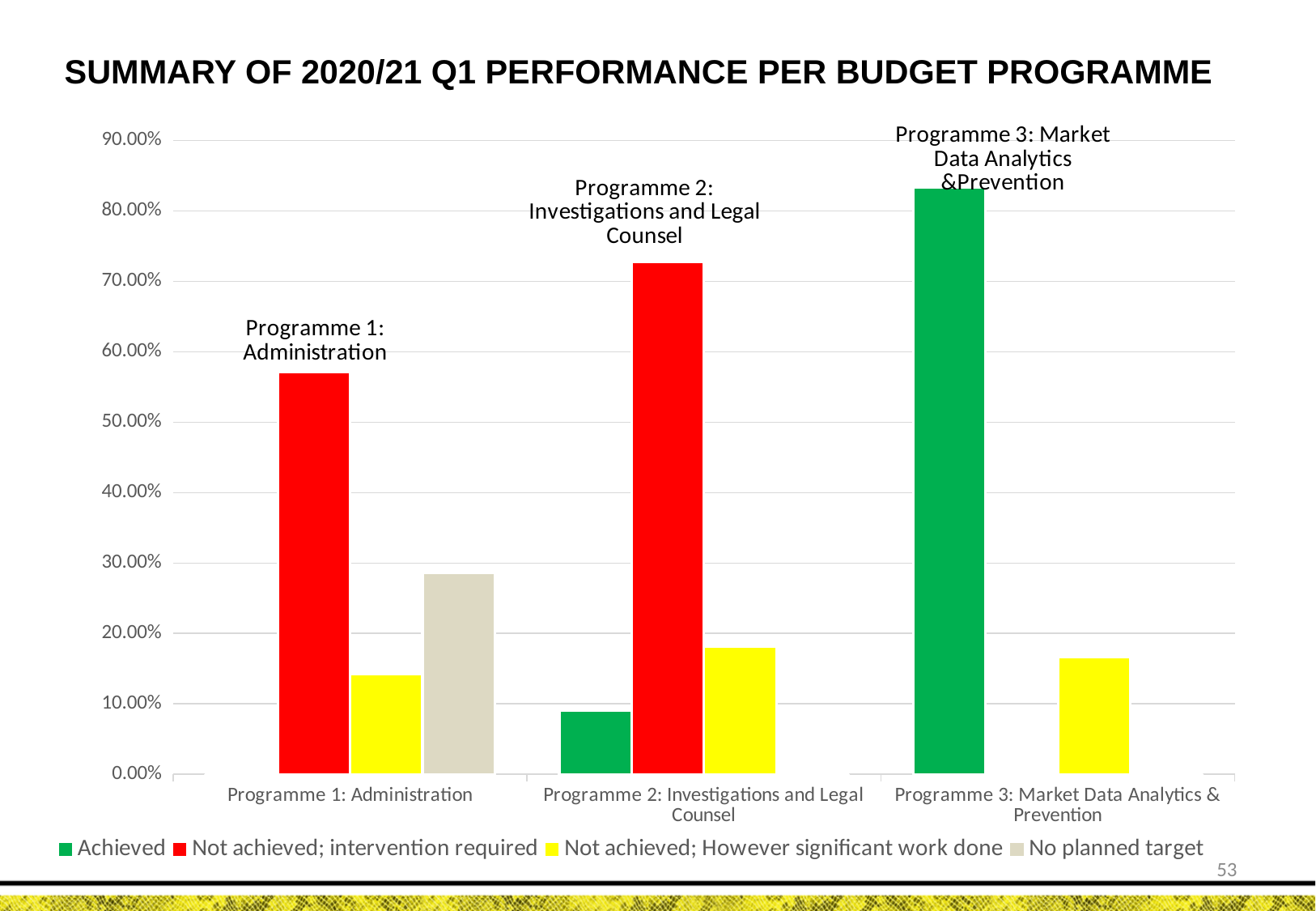
Which programme has the tallest 'Achieved' bar? Programme 3: Market Data Analytics & Prevention What colour represents the 'Achieved' series in the legend? green Is the 'Not achieved; intervention required' value for Programme 1: Administration greater or less than 60.00%? less What kind of chart is shown on the slide? bar chart How many budget programmes are shown on the x axis? 3 Which programme is the only one with a 'No planned target' bar? Programme 1: Administration Is the 'No planned target' value for Programme 1: Administration greater or less than 20.00%? greater Is the 'Achieved' value for Programme 3: Market Data Analytics & Prevention greater or less than 80.00%? greater How many series does the legend list? 4 Which programme has the tallest 'Not achieved; intervention required' bar? Programme 2: Investigations and Legal Counsel Which is larger for Programme 2: Investigations and Legal Counsel, the 'Not achieved; intervention required' bar or the 'Not achieved; However significant work done' bar? Not achieved; intervention required